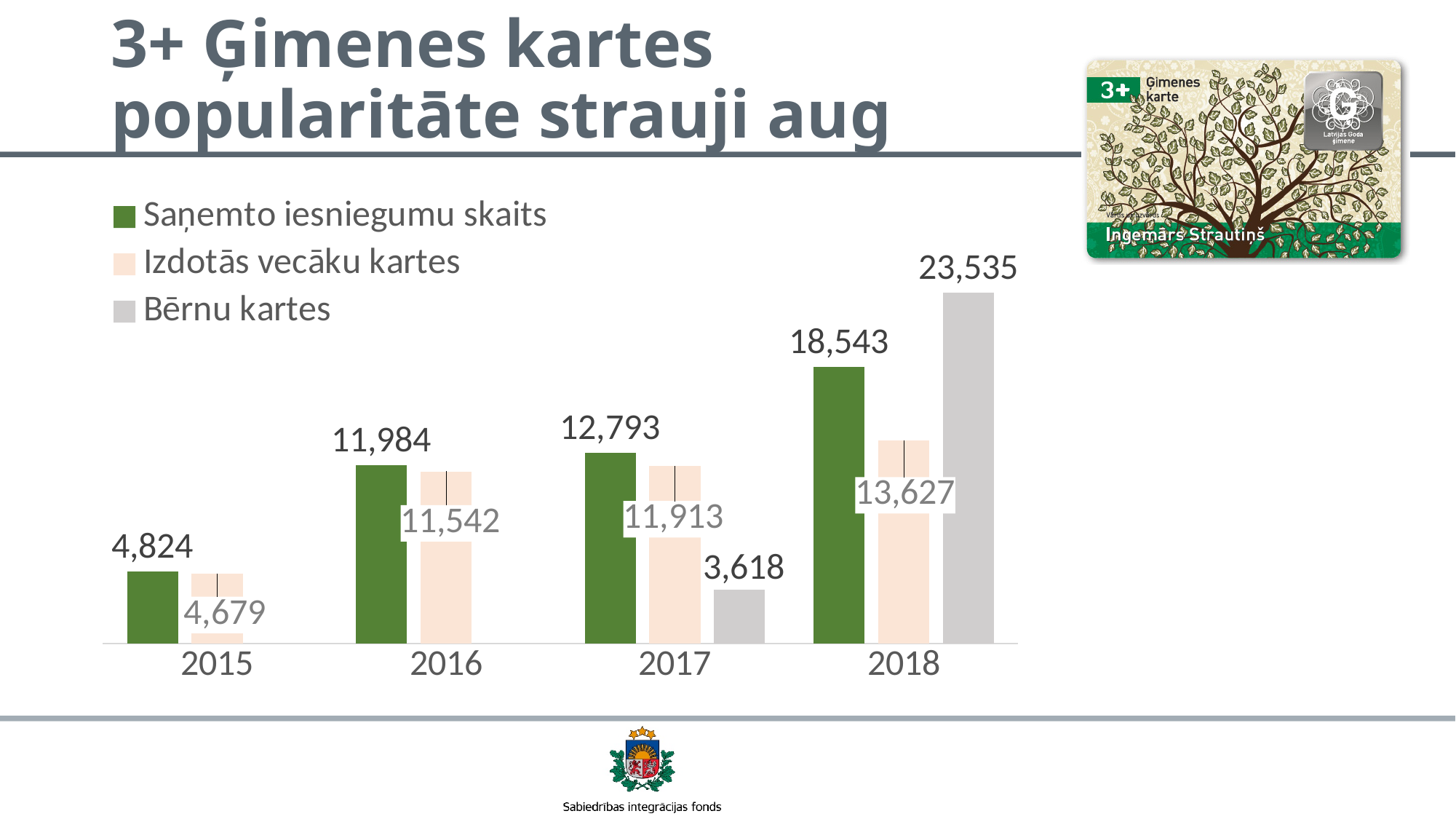
What is the difference between Saņemto iesniegumu skaits and Izdotās vecāku kartes in 2018? 4,916 What is the value of Bērnu kartes in 2018? 23,535 In which year is Izdotās vecāku kartes lowest? 2015 What is the value of Bērnu kartes in 2017? 3,618 What kind of chart is shown on the slide? bar chart How many series does the legend list? 3 Does Saņemto iesniegumu skaits rise or fall from 2015 to 2018? rise What is the value of Izdotās vecāku kartes in 2016? 11,542 In which year is Saņemto iesniegumu skaits highest? 2018 What is the value of Saņemto iesniegumu skaits in 2015? 4,824 In 2018, which is larger: Bērnu kartes or Saņemto iesniegumu skaits? Bērnu kartes How many years are shown on the x axis? 4